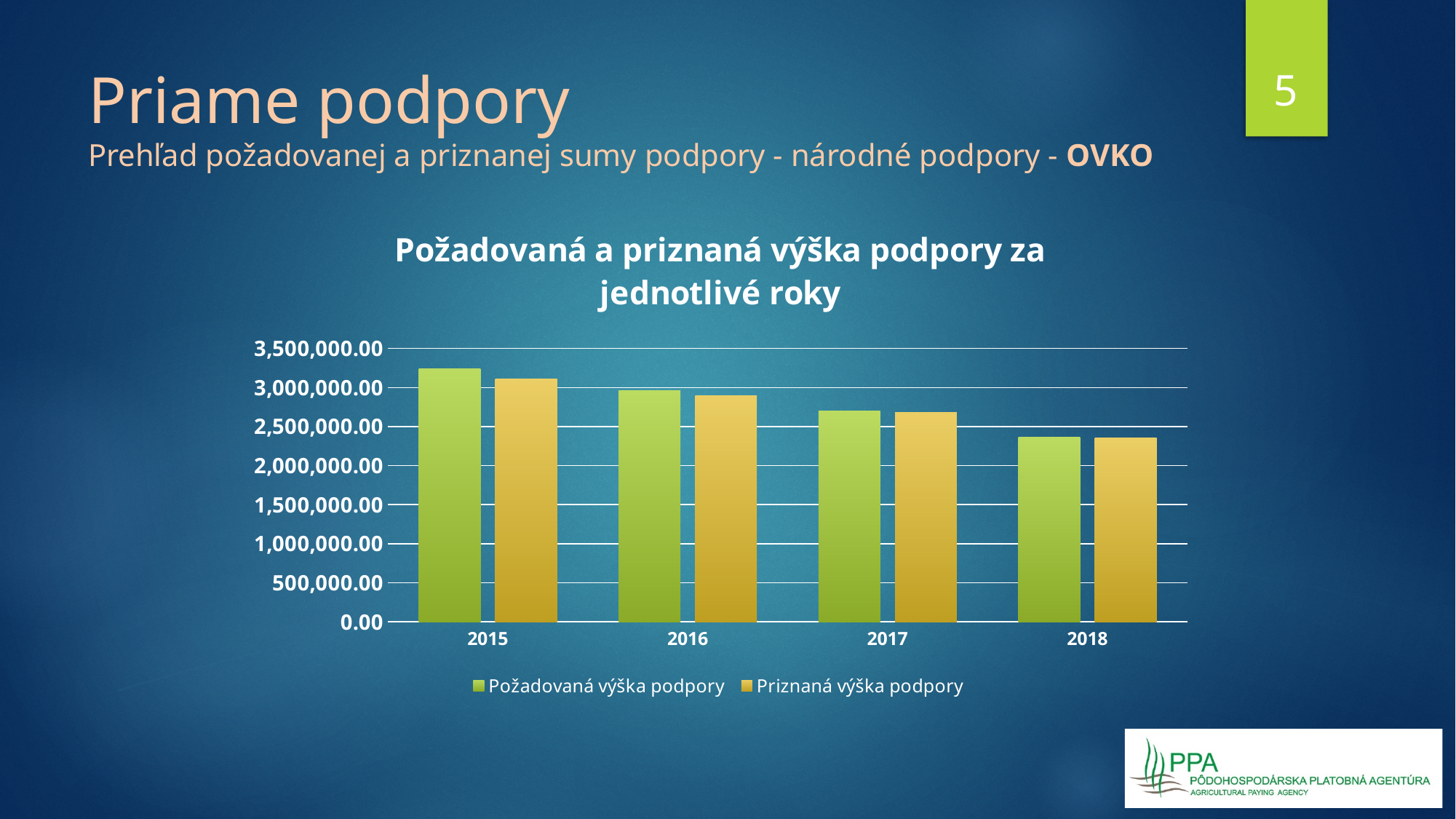
Which year has the highest value for Požadovaná výška podpory? 2015 Is the value for Priznaná výška podpory in 2017 greater or less than 2,500,000.00? greater Which is larger in 2015: Požadovaná výška podpory or Priznaná výška podpory? Požadovaná výška podpory Is the value for Požadovaná výška podpory in 2015 greater or less than 3,000,000.00? greater Is the value for Priznaná výška podpory in 2016 greater or less than 3,000,000.00? less How many series does the chart legend list? 2 What kind of chart is shown on the slide? bar chart How many years are shown on the x axis of the chart? 4 What is the title of the chart? Požadovaná a priznaná výška podpory za jednotlivé roky Which year has the lowest value for Priznaná výška podpory? 2018 Do the values for Požadovaná výška podpory rise or fall from 2015 to 2018? fall